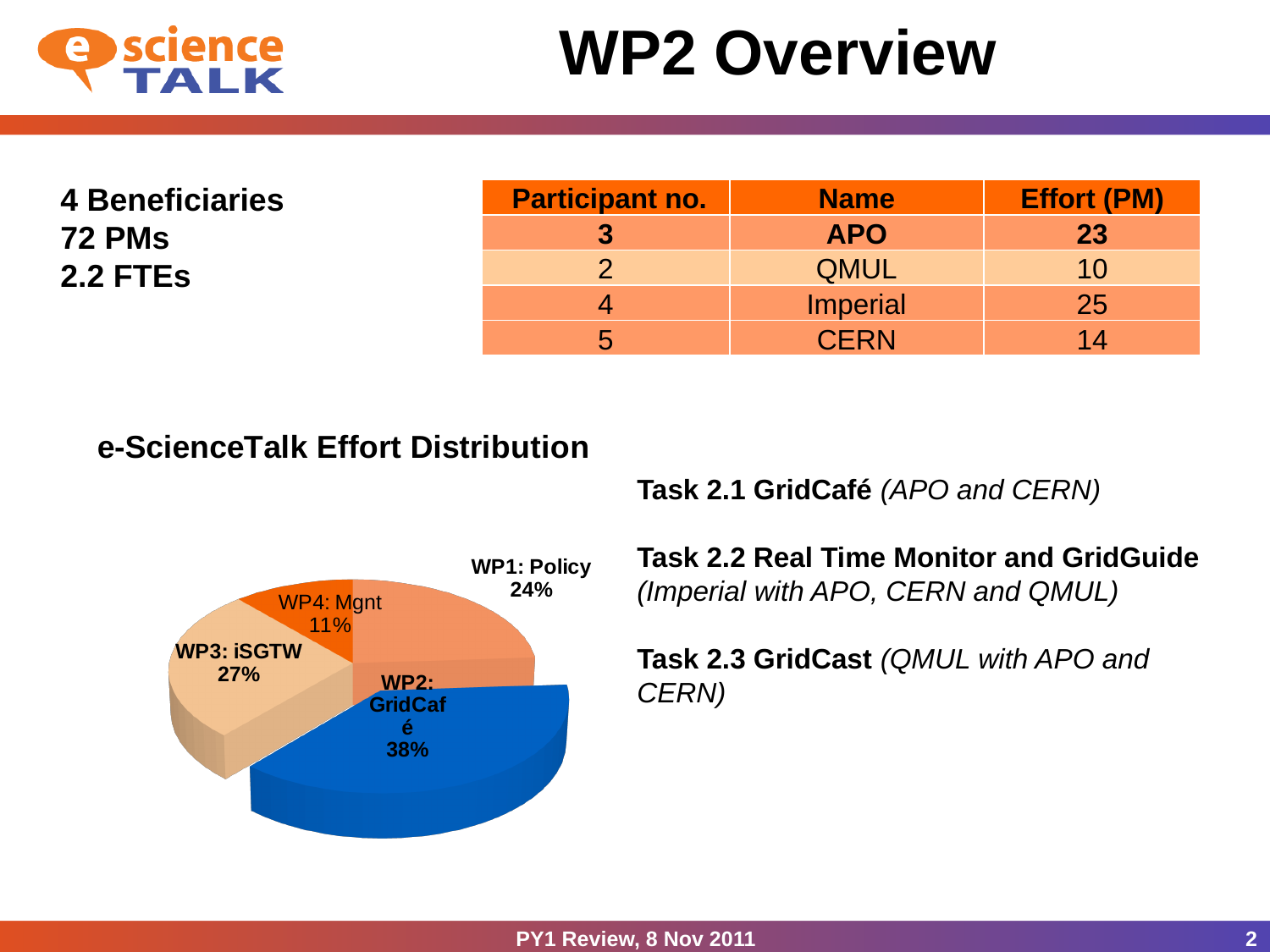
What is the title of the pie chart? e-ScienceTalk Effort Distribution What share of effort does WP2: GridCafé have in the pie chart? 38% Which work package has the smallest share in the pie chart? WP4: Mgnt What is the difference in percentage points between WP2: GridCafé and WP3: iSGTW? 11 Which work package has the largest share in the pie chart? WP2: GridCafé What kind of chart is shown on the slide? Pie chart What share of effort does WP4: Mgnt have in the pie chart? 11% What share of effort does WP3: iSGTW have in the pie chart? 27% Which has a larger share, WP1: Policy or WP3: iSGTW? WP3: iSGTW How many slices does the pie chart have? 4 What colour is the WP2: GridCafé slice in the pie chart? Blue